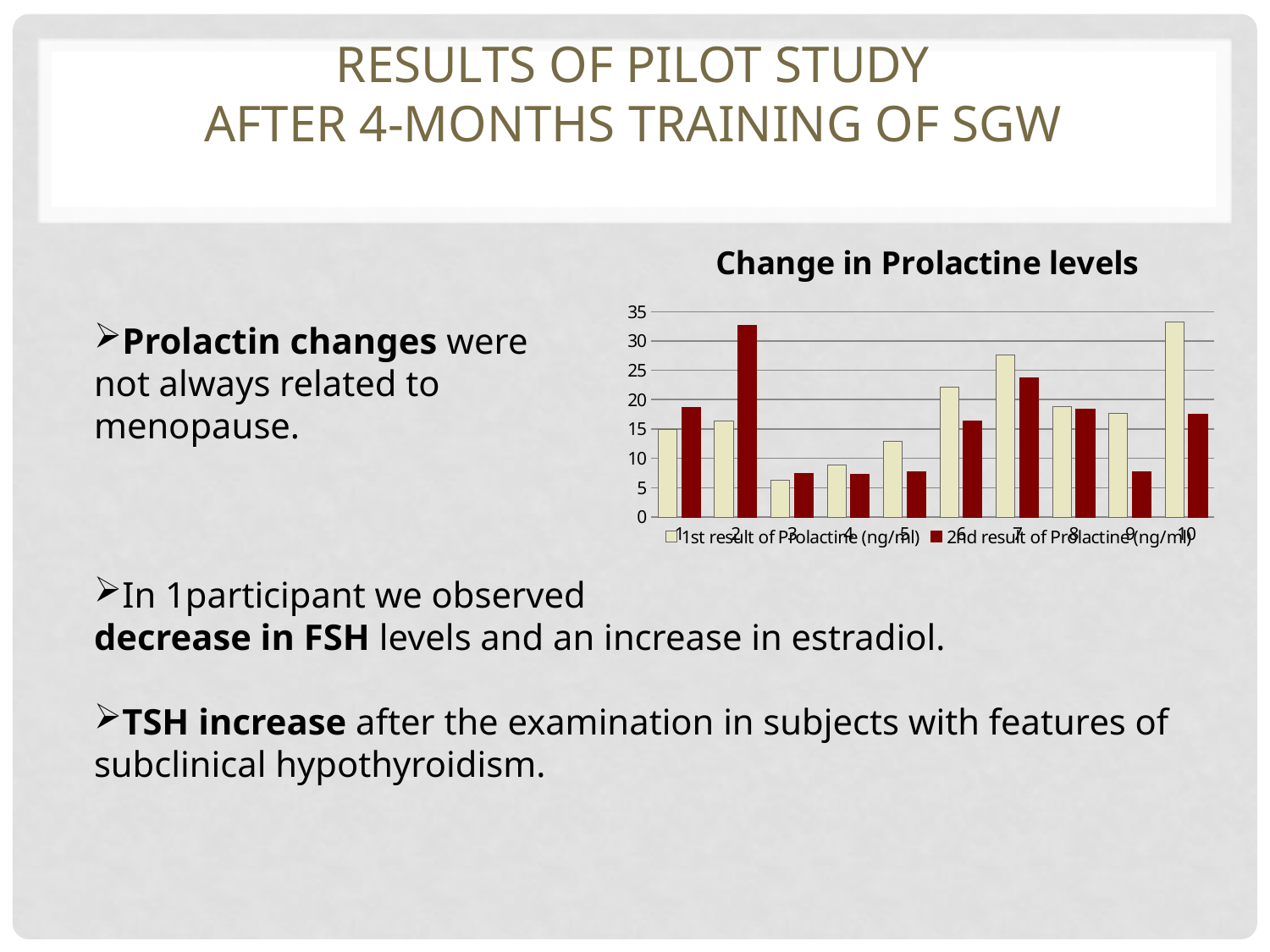
Which participant has the highest 2nd result of Prolactine (ng/ml)? 2 For participant 1, which is larger: the 1st result or the 2nd result of Prolactine? 2nd result Is the 2nd result of Prolactine for participant 2 greater or less than 30? greater What kind of chart is shown on the slide? bar chart Which participant has the highest 1st result of Prolactine (ng/ml)? 10 For participant 9, which is larger: the 1st result or the 2nd result of Prolactine? 1st result Is the 1st result of Prolactine for participant 3 greater or less than 10? less What is the title of the chart? Change in Prolactine levels How many series does the chart's legend list? 2 Is the 1st result of Prolactine for participant 10 greater or less than 30? greater Which participant has the lowest 1st result of Prolactine (ng/ml)? 3 How many participants (categories) are shown on the x axis of the chart? 10